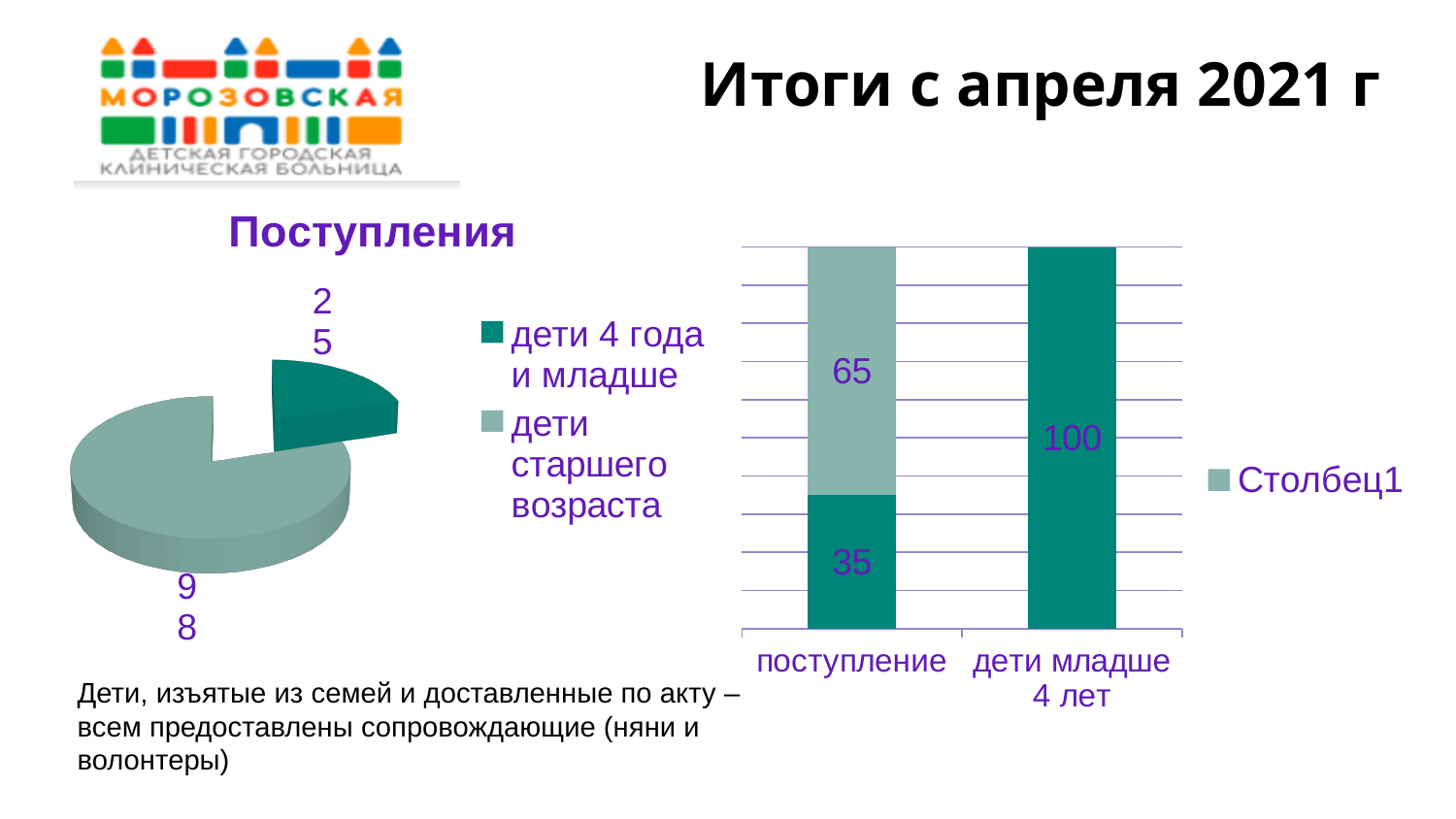
What entry does the legend of the bar chart on the right show? Столбец1 In the bar chart on the right, what is the difference between the two segments of the "поступление" bar (65 and 35)? 30 In the bar chart on the right, what is the value of the upper (light) segment of the "поступление" bar? 65 What is the title of the pie chart on the left? Поступления In the bar chart on the right, what is the total of the stacked "поступление" bar? 100 What kind of chart is the chart on the left titled "Поступления"? pie chart In the bar chart on the right, what is the value of the lower (dark) segment of the "поступление" bar? 35 In the pie chart "Поступления", which slice is larger: "дети 4 года и младше" or "дети старшего возраста"? дети старшего возраста How many categories are shown on the x axis of the bar chart on the right? 2 What kind of chart is the chart on the right of the slide? bar chart In the pie chart "Поступления", how many entries does the legend list? 2 In the bar chart on the right, what is the value for "дети младше 4 лет"? 100